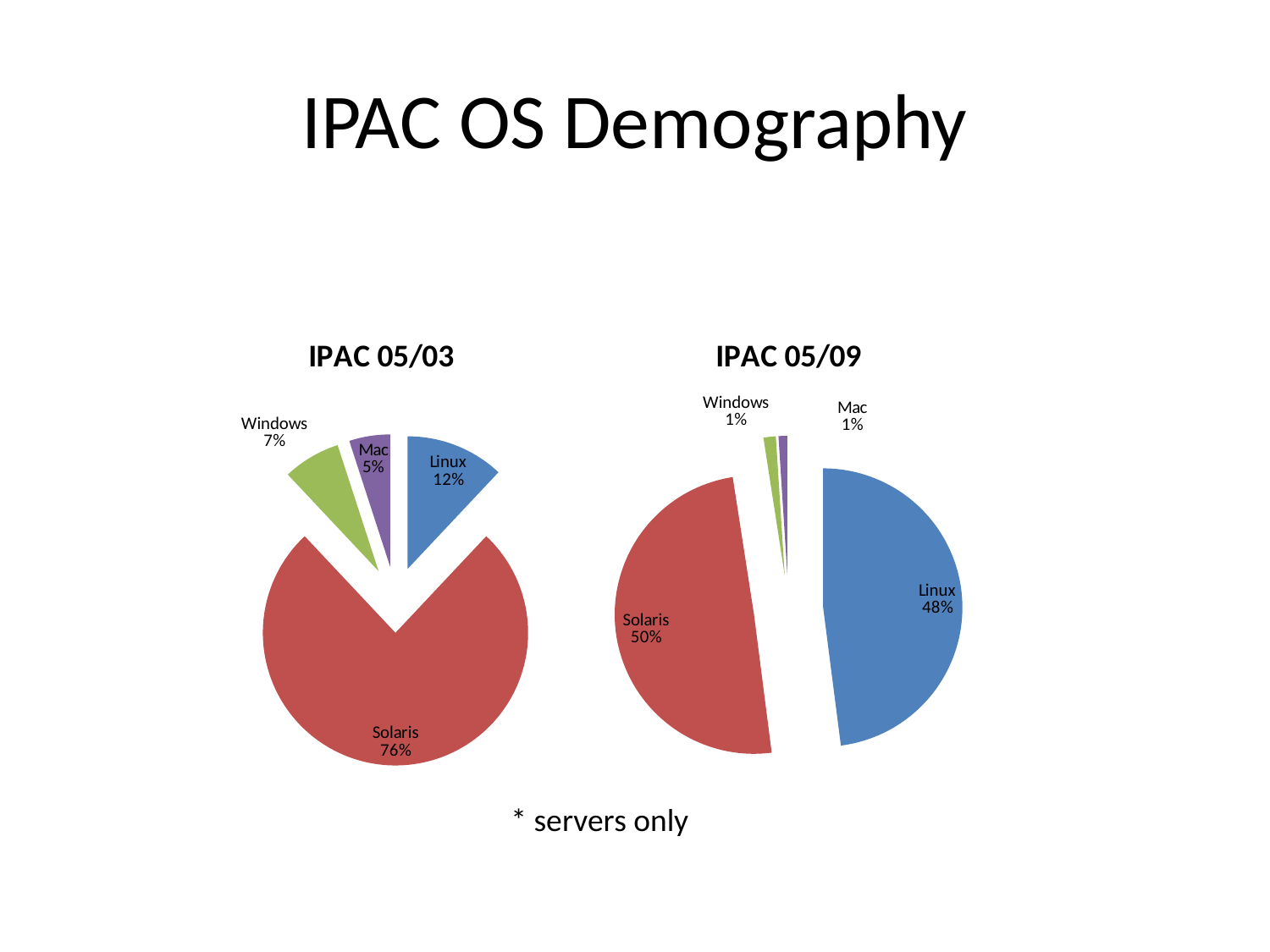
In the IPAC 05/09 chart, what share does Solaris have? 50% In the IPAC 05/03 chart, what share does Solaris have? 76% In the IPAC 05/09 chart, which operating system has the largest slice? Solaris In the IPAC 05/03 chart, which operating system has the smallest slice? Mac In the IPAC 05/03 chart, which is larger, the Windows share or the Mac share? Windows In the IPAC 05/09 chart, what share does Linux have? 48% How many slices does the IPAC 05/09 chart have? 4 In the IPAC 05/03 chart, which operating system has the largest slice? Solaris What is the title of the chart on the right of the slide? IPAC 05/09 In the IPAC 05/03 chart, what is the difference between the Solaris and Linux shares? 64% What kind of chart is the IPAC 05/03 chart? Pie chart